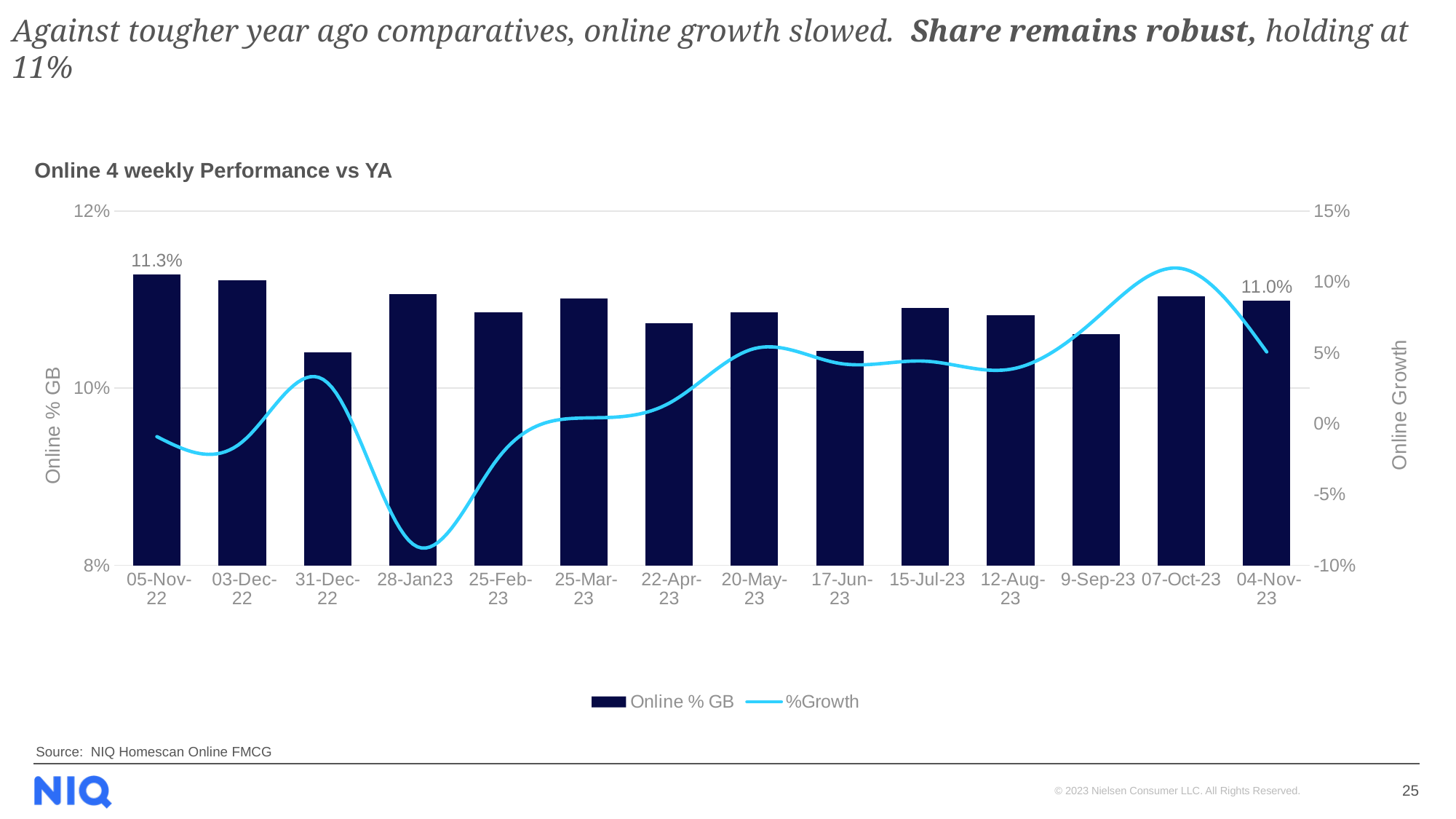
What is the Online % GB value for 05-Nov-22? 11.3% Which is larger, the Online % GB bar for 05-Nov-22 or for 31-Dec-22? 05-Nov-22 Is the Online % GB value for 31-Dec-22 greater or less than 10%? greater Which period has the lowest %Growth value on the line? 28-Jan23 Which period has the highest %Growth value on the line? 07-Oct-23 What is the Online % GB value for 04-Nov-23? 11.0% How many periods are shown on the x axis? 14 By how many percentage points does the Online % GB for 05-Nov-22 exceed that for 04-Nov-23? 0.3 percentage points How many series does the legend list? 2 What kind of chart is shown on the slide? Combined bar and line chart Is the %Growth value for 28-Jan23 greater or less than -5%? less